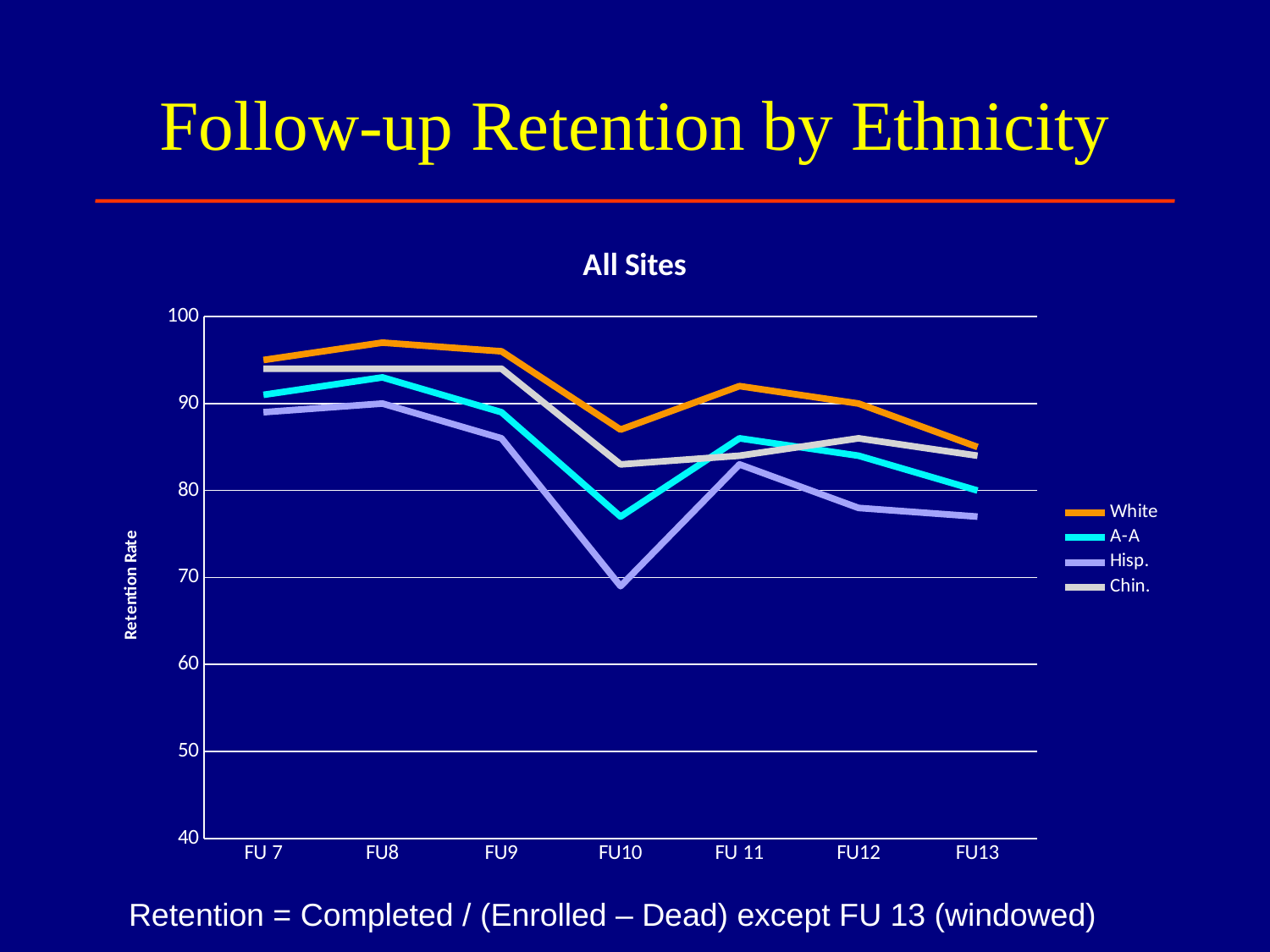
How many follow-up points are plotted along the x axis? 7 What is the title shown above the chart? All Sites Is the value for A-A at FU10 greater or less than 80? less What is the label on the vertical axis? Retention Rate What kind of chart is shown on the slide? Line chart Is the value for Hisp. at FU10 greater or less than 80? less Is the value for White at FU8 greater or less than 90? greater How many series does the legend list? 4 Which series has the highest value at FU10? White Does the White series overall rise or fall from FU 7 to FU13? fall Which series has the lowest value at FU10? Hisp.